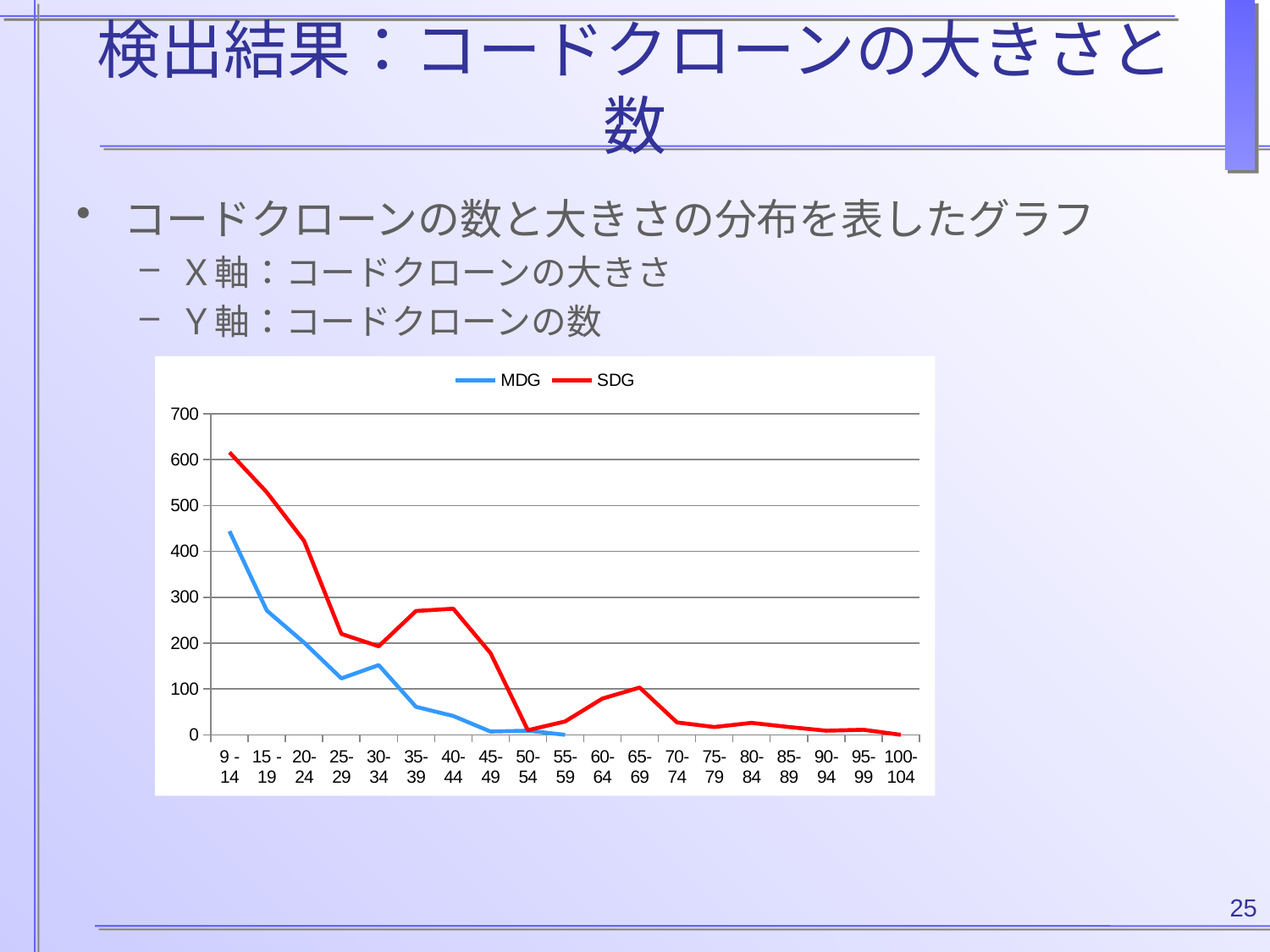
Which series is drawn in blue? MDG Which series has the larger value for 9 - 14, MDG or SDG? SDG What kind of chart is shown on the slide? line chart How many categories are shown on the x axis? 19 Is the MDG value for 9 - 14 greater or less than 400? greater Is the SDG value for 40-44 greater or less than 200? greater Do the SDG values generally rise or fall from left to right along the x axis? fall For which category does the SDG series reach its highest value? 9 - 14 Is the MDG value for 35-39 greater or less than 100? less Which series is drawn in red? SDG How many series does the legend list? 2